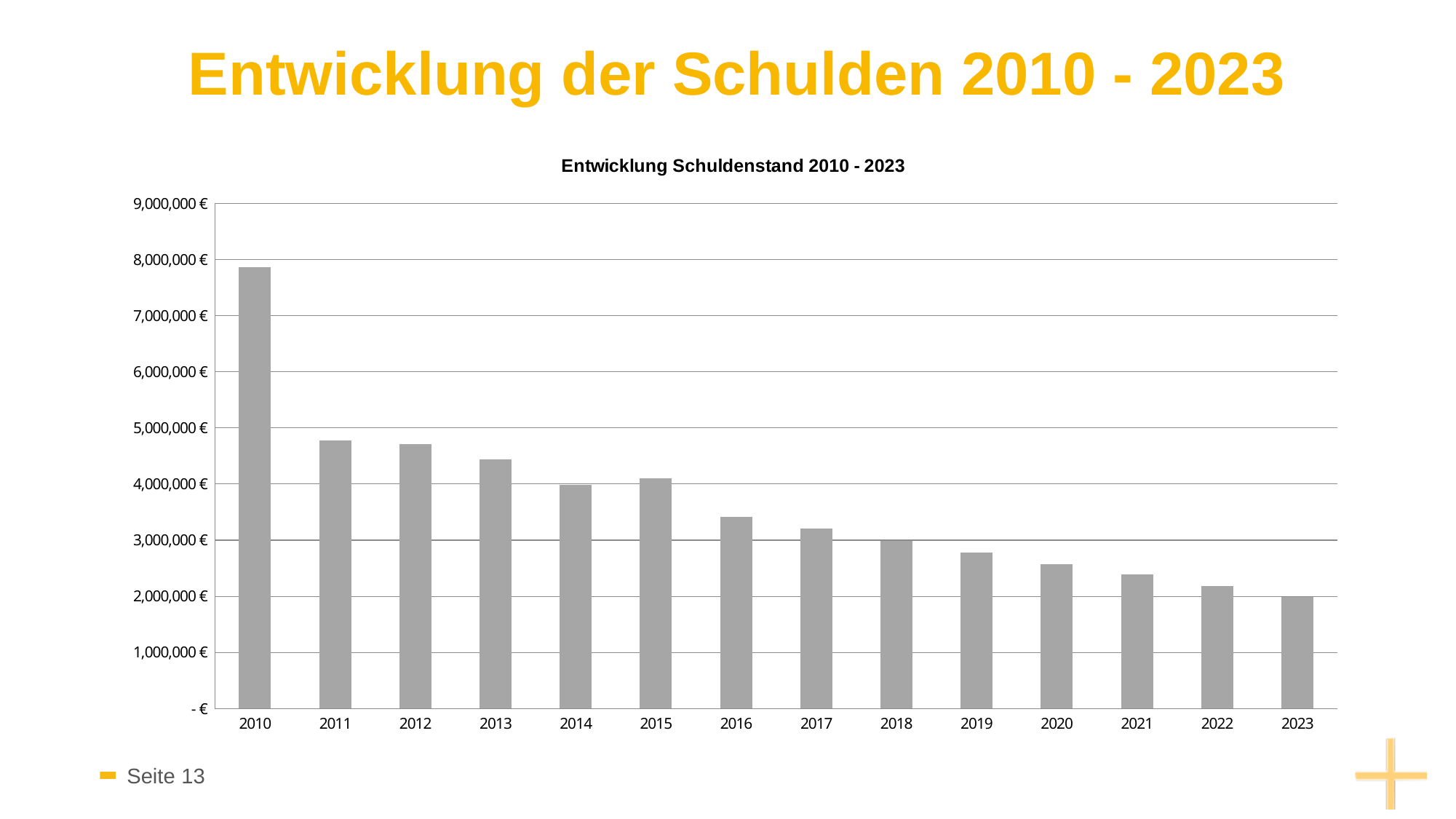
Which year has the lowest value in the chart? 2023 What kind of chart is shown on the slide? bar chart Which is larger, the value for 2014 or the value for 2015? 2015 How many years are shown on the x axis of the chart? 14 Which year has the highest value in the chart? 2010 Is the value for 2010 greater or less than 7,000,000 €? greater Which is larger, the value for 2010 or the value for 2011? 2010 Is the value for 2021 greater or less than 3,000,000 €? less Is the value for 2016 greater or less than 3,000,000 €? greater Do the values generally rise or fall from 2010 to 2023? fall What is the title of the chart? Entwicklung Schuldenstand 2010 - 2023